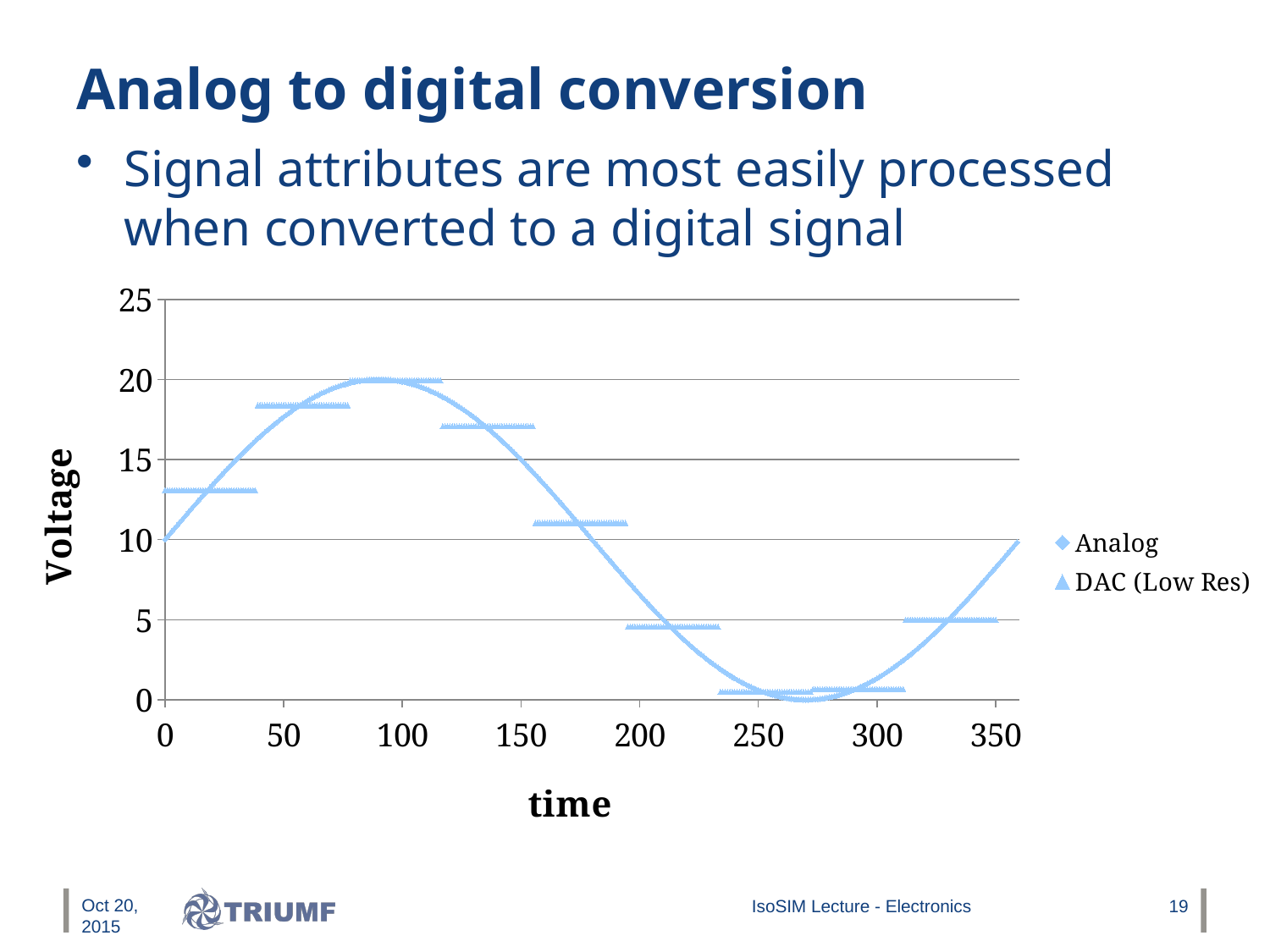
How many series does the chart legend list? 2 Which is larger, the Analog voltage at time 50 or at time 300? time 50 What is the Analog voltage at time 0? 10 Is the Analog voltage at time 250 greater or less than 5? less Is the Analog voltage at time 100 greater or less than 15? greater Does the Analog voltage rise or fall between time 0 and time 50? rise Is the DAC (Low Res) voltage at time 200 greater or less than 10? less Does the Analog voltage rise or fall between time 150 and time 250? fall What is the label on the vertical axis of the chart? Voltage What are the two series named in the chart legend? Analog and DAC (Low Res) What kind of chart is shown on the slide? line chart